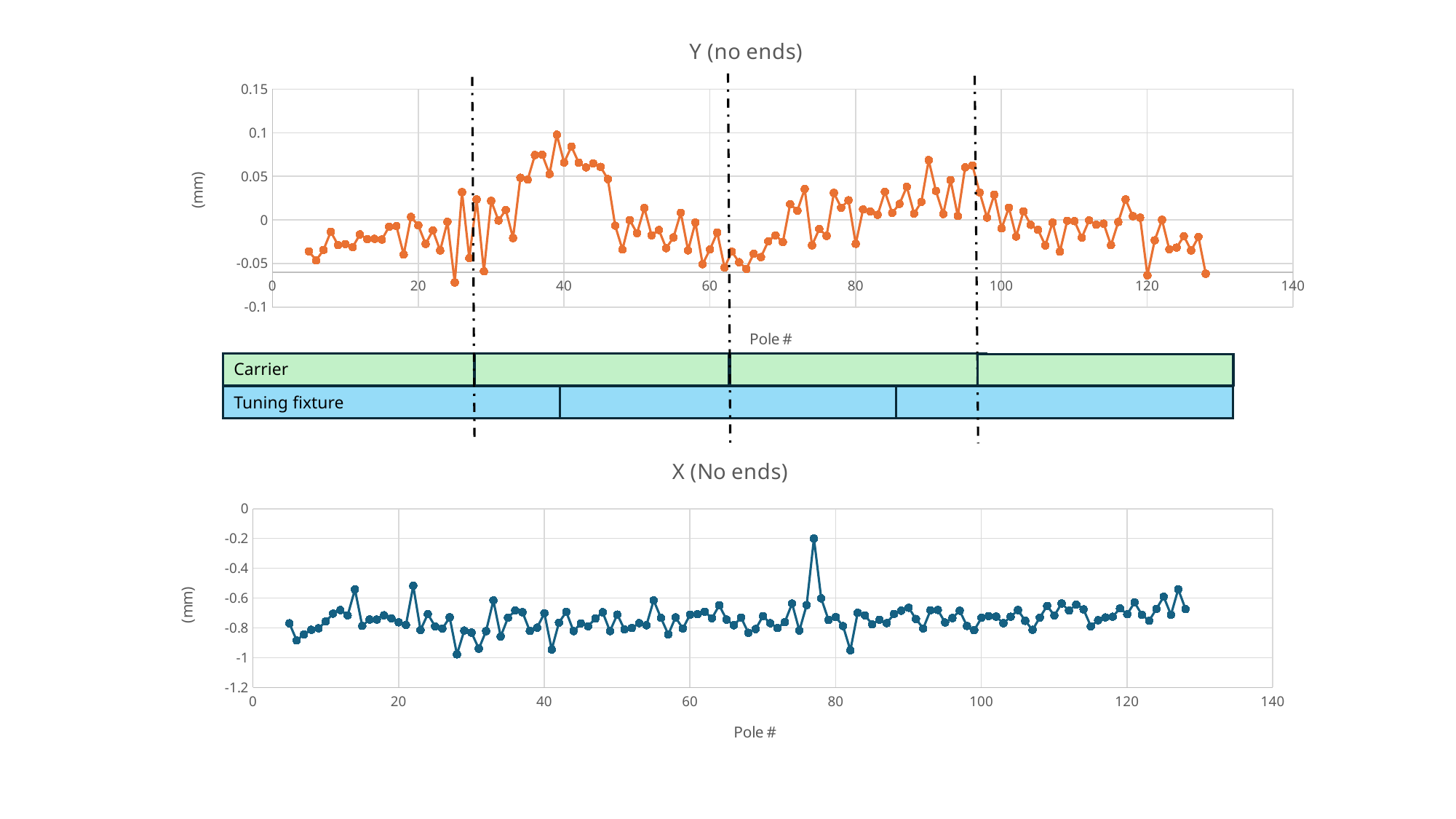
In the "X (No ends)" chart, is the highest plotted value greater or less than -0.4? greater In the "X (No ends)" chart, is the value at pole 60 greater or less than -0.4? less In the "Y (no ends)" chart, is the lowest plotted value greater or less than -0.05? less What is the x-axis label of the "X (No ends)" chart? Pole # What unit is shown on the y-axis of the "Y (no ends)" chart? (mm) What kind of chart is the "Y (no ends)" chart? line chart What kind of chart is the "X (No ends)" chart? line chart